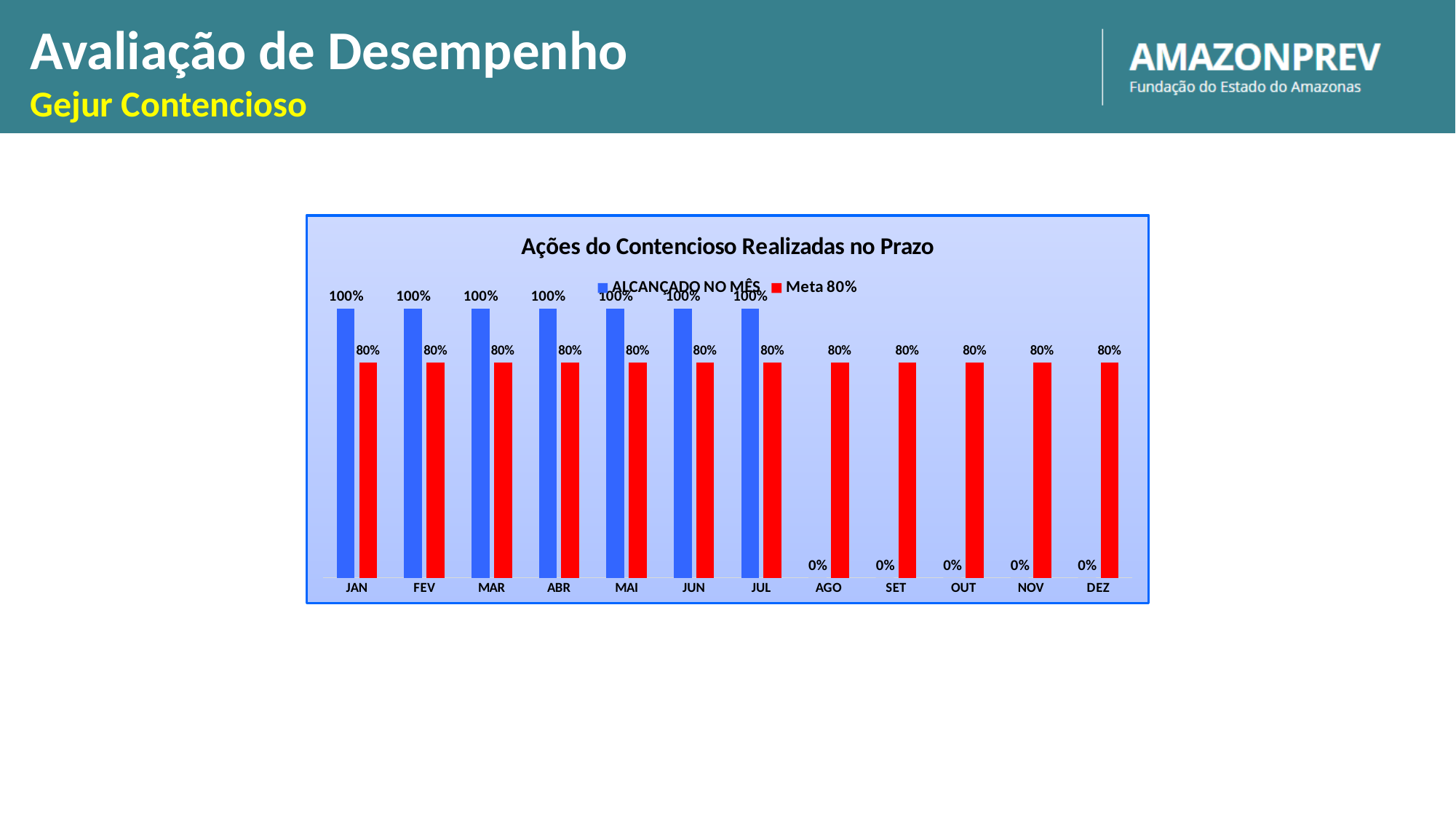
What is the ALCANÇADO NO MÊS value for SET? 0% How many months have an ALCANÇADO NO MÊS value of 100%? 7 How many months are shown on the x axis? 12 What type of chart is shown on the slide? bar chart How many series does the legend list? 2 What is the difference between the ALCANÇADO NO MÊS value and the Meta 80% value for JAN? 20% What is the title of the chart? Ações do Contencioso Realizadas no Prazo What is the ALCANÇADO NO MÊS value for MAR? 100% What is the Meta 80% value for NOV? 80% Which is larger for AGO, the ALCANÇADO NO MÊS value or the Meta 80% value? Meta 80% What colour are the Meta 80% bars? red Which is larger for JUL, the ALCANÇADO NO MÊS value or the Meta 80% value? ALCANÇADO NO MÊS